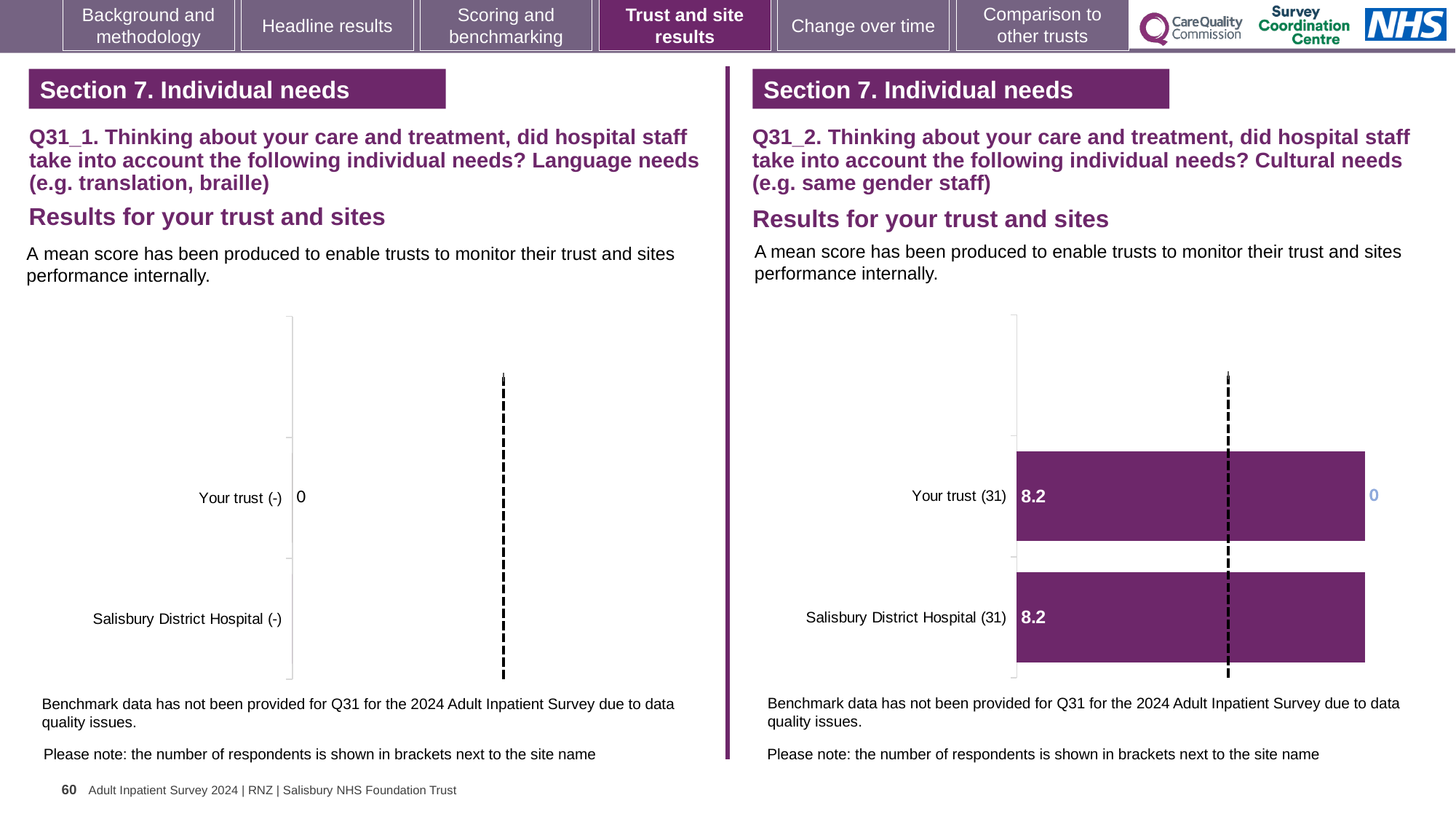
What kind of chart is the Q31_2 chart (Cultural needs) on the right? Bar chart In the Q31_1 chart (Language needs) on the left, what value is shown for Your trust? 0 In the Q31_2 chart (Cultural needs) on the right, what is the difference between the scores for Your trust and Salisbury District Hospital? 0 In the Q31_2 chart (Cultural needs) on the right, what is the mean score for Your trust? 8.2 In the Q31_2 chart (Cultural needs) on the right, is the score for Salisbury District Hospital greater or less than 5? greater In the Q31_1 chart (Language needs) on the left, how many categories are listed on the axis? 2 In the Q31_2 chart (Cultural needs) on the right, what is the mean score for Salisbury District Hospital? 8.2 In the Q31_2 chart (Cultural needs) on the right, how many respondents are shown in brackets next to Your trust? 31 In the Q31_2 chart (Cultural needs) on the right, how many categories are plotted? 2 In the Q31_1 chart (Language needs) on the left, what is shown in brackets next to Salisbury District Hospital? -